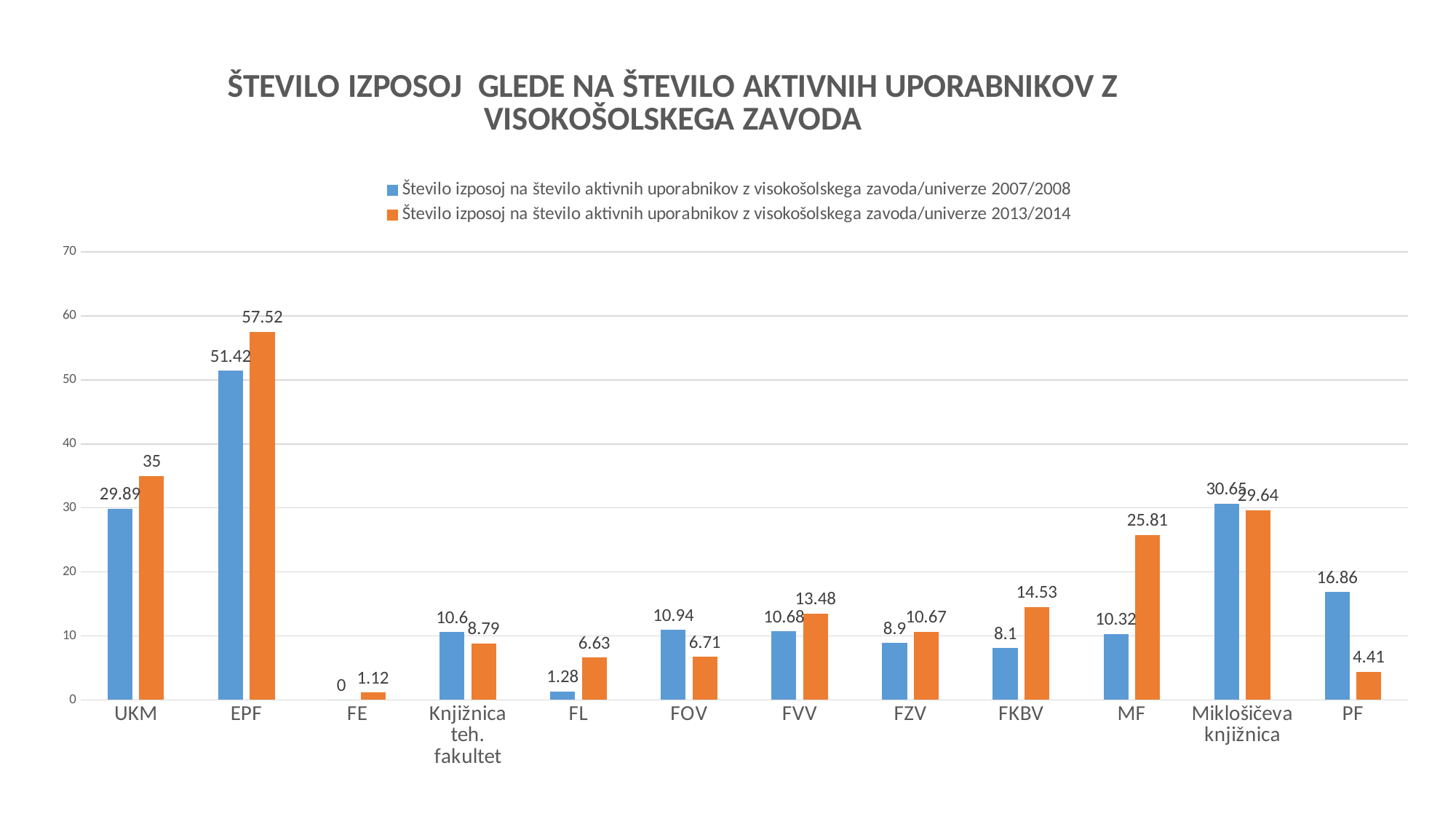
How many categories are shown on the x axis? 12 Is the 2013/2014 value for FKBV greater or less than 10? greater For PF, which series has the larger value, 2007/2008 or 2013/2014? 2007/2008 How many series does the legend list? 2 Which category has the lowest value in the 2013/2014 series? FE What is the value for EPF in the 2013/2014 series? 57.52 What is the value for PF in the 2013/2014 series? 4.41 What kind of chart is shown on the slide? Bar chart What is the difference between the 2013/2014 and 2007/2008 values for UKM? 5.11 Which category has the highest value in the 2007/2008 series? EPF What is the value for MF in the 2007/2008 series? 10.32 What is the difference between the 2013/2014 and 2007/2008 values for MF? 15.49